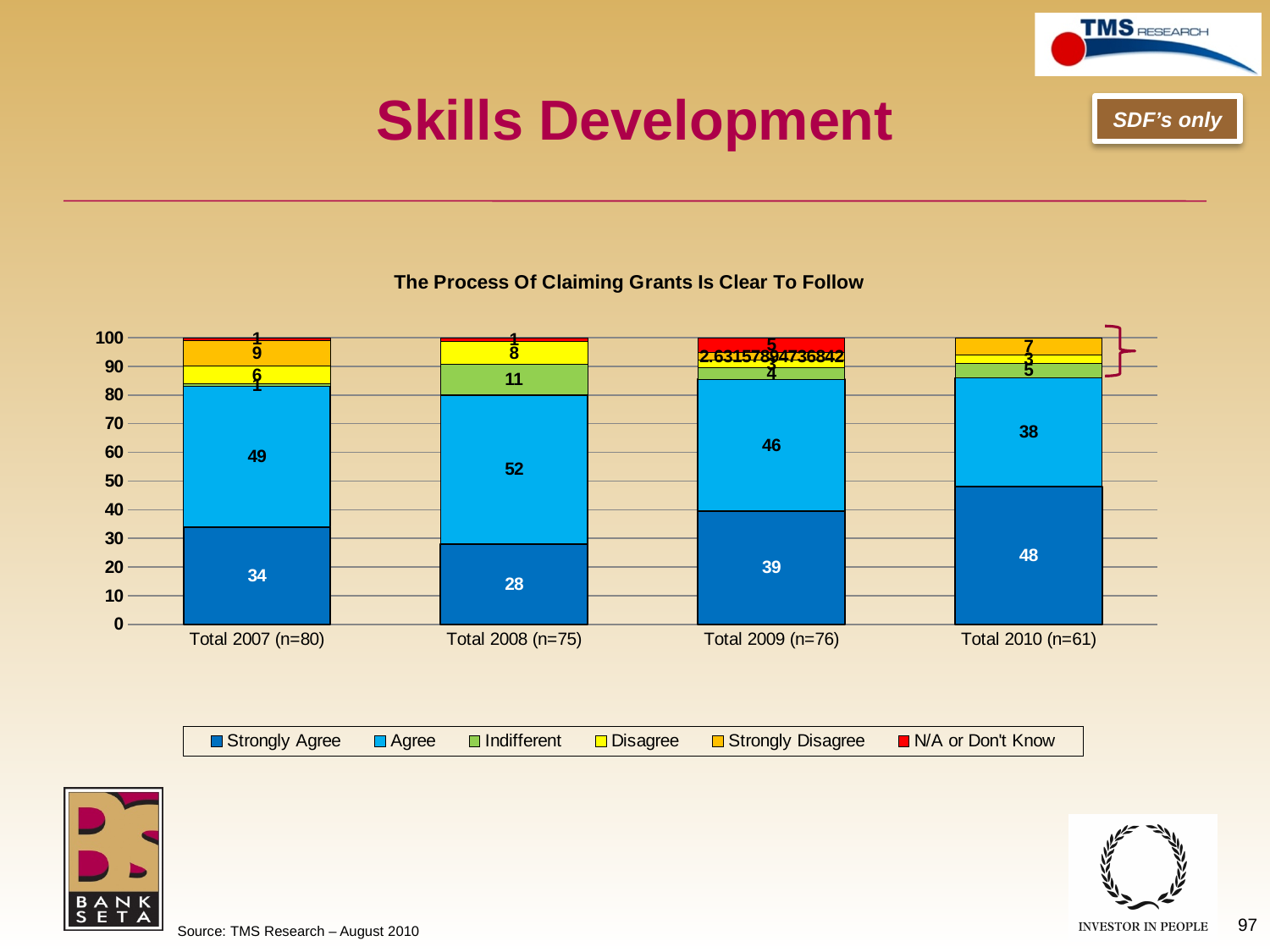
Which category has the lowest Strongly Agree value? Total 2008 (n=75) Which is larger, the Agree value for Total 2009 (n=76) or the Agree value for Total 2010 (n=61)? Total 2009 (n=76) Does the Strongly Agree value rise or fall from Total 2008 (n=75) to Total 2010 (n=61)? rise What is the Indifferent value for Total 2008 (n=75)? 11 How many categories are shown on the x axis? 4 How many series does the legend list? 6 What is the difference between the Strongly Agree values for Total 2010 (n=61) and Total 2007 (n=80)? 14 Which category has the highest Strongly Agree value? Total 2010 (n=61) What kind of chart is shown on the slide? stacked bar chart What is the Strongly Agree value for Total 2010 (n=61)? 48 What is the title of the chart? The Process Of Claiming Grants Is Clear To Follow What is the Agree value for Total 2008 (n=75)? 52